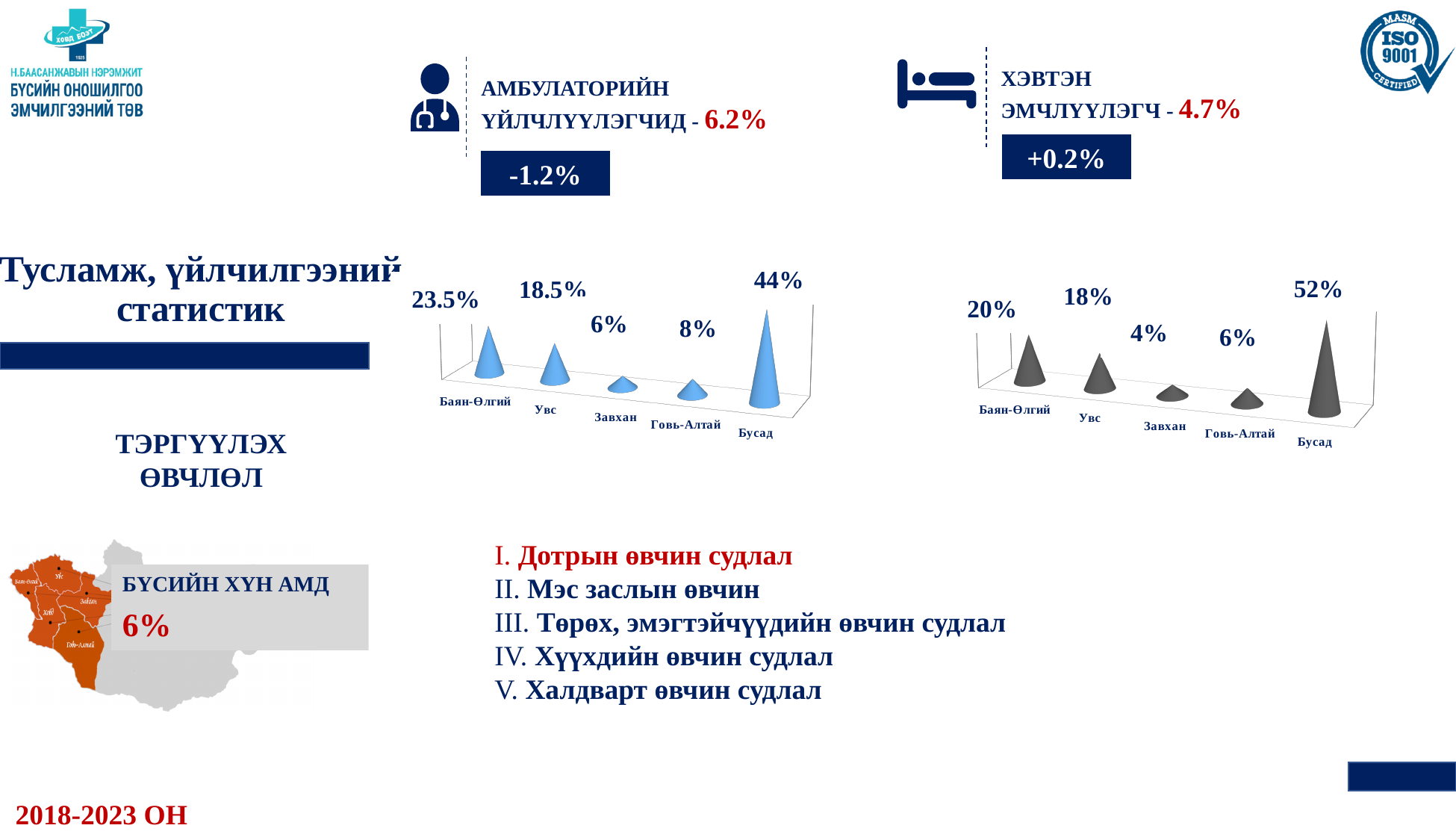
How many categories are shown in the left chart (blue cones)? 5 In the right chart (grey cones), which is larger, the value for Баян-Өлгий or the value for Говь-Алтай? Баян-Өлгий What type of chart is the right chart (grey cones)? 3D cone bar chart In the right chart (grey cones), what is the value for Увс? 18% In the left chart (blue cones), which category has the lowest value? Завхан In the right chart (grey cones), what is the value for Завхан? 4% In the right chart (grey cones), which category has the lowest value? Завхан In the left chart (blue cones), what is the difference between the values for Баян-Өлгий and Увс? 5% In the left chart (blue cones), which category has the highest value? Бусад In the right chart (grey cones), which category has the highest value? Бусад In the left chart (blue cones), what is the value for Баян-Өлгий? 23.5% In the left chart (blue cones), what is the value for Говь-Алтай? 8%